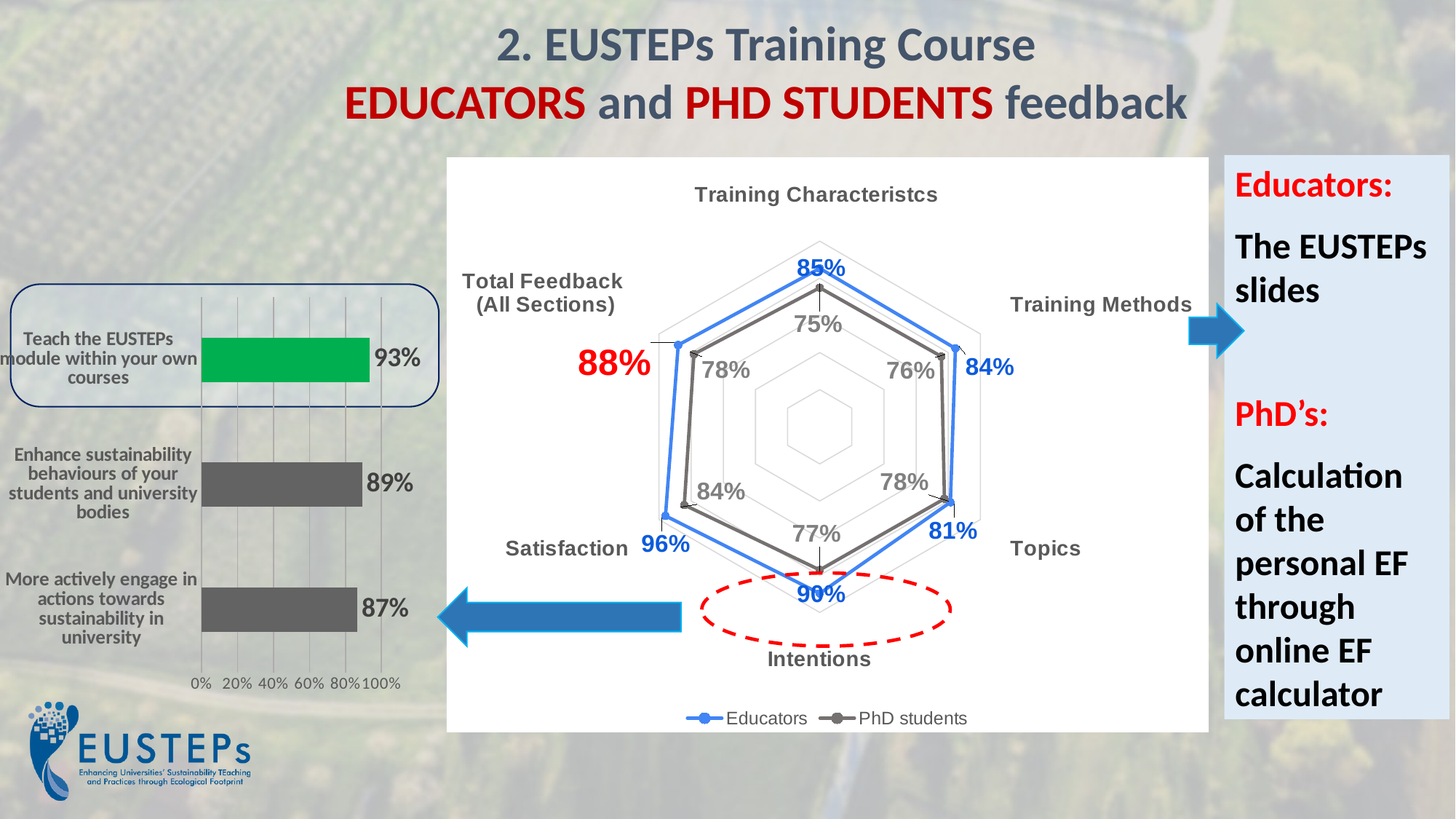
In the bar chart on the left, which category has the lowest value? More actively engage in actions towards sustainability in university In the radar chart, which axis has the highest Educators value? Satisfaction In the radar chart, what is the Educators value for Satisfaction? 96% In the radar chart, which series has the larger value for Training Methods, Educators or PhD students? Educators In the radar chart, which axis has the lowest PhD students value? Training Characteristcs In the radar chart, what is the difference between the Educators and PhD students values for Intentions? 13% In the radar chart, what is the PhD students value for Training Characteristcs? 75% In the radar chart, what is the PhD students value for Topics? 78% In the radar chart, what is the Educators value for Intentions? 90% How many series does the legend of the radar chart list? 2 In the bar chart on the left, what is the value for 'Teach the EUSTEPs module within your own courses'? 93% What kind of chart is the chart on the left of the slide? Bar chart